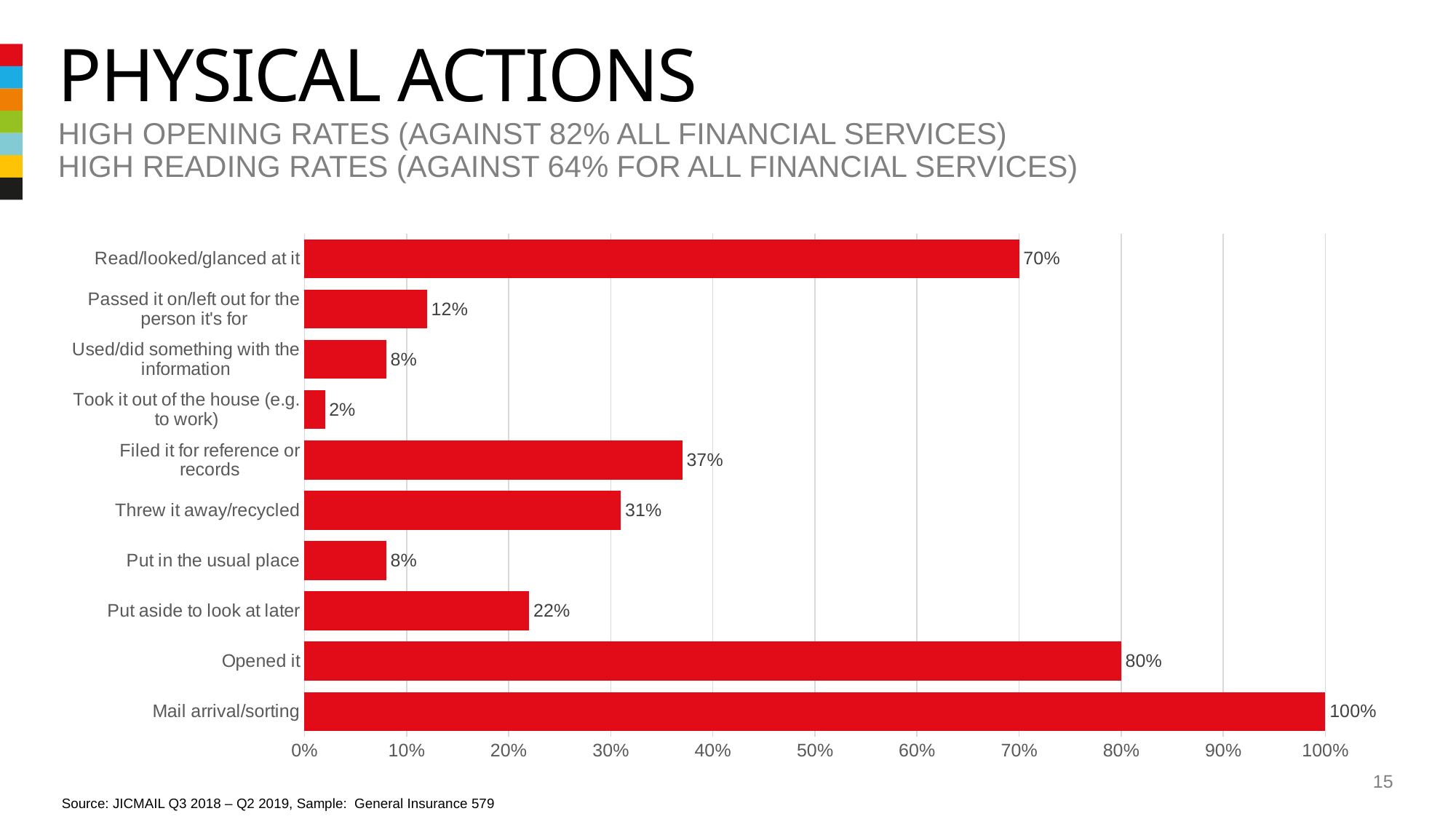
Which category has the highest value? Mail arrival/sorting What is the difference between the values for Opened it and Read/looked/glanced at it? 10% What is the difference between the values for Filed it for reference or records and Threw it away/recycled? 6% What kind of chart is shown on the slide? Bar chart What is the value for Opened it? 80% Which category has the lowest value? Took it out of the house (e.g. to work) How many categories are shown in the chart? 10 What is the value for Put aside to look at later? 22% Is the value for Threw it away/recycled greater or less than 40%? less Which is larger, the value for Passed it on/left out for the person it's for or the value for Used/did something with the information? Passed it on/left out for the person it's for What colour are the bars in the chart? Red What is the value for Filed it for reference or records? 37%